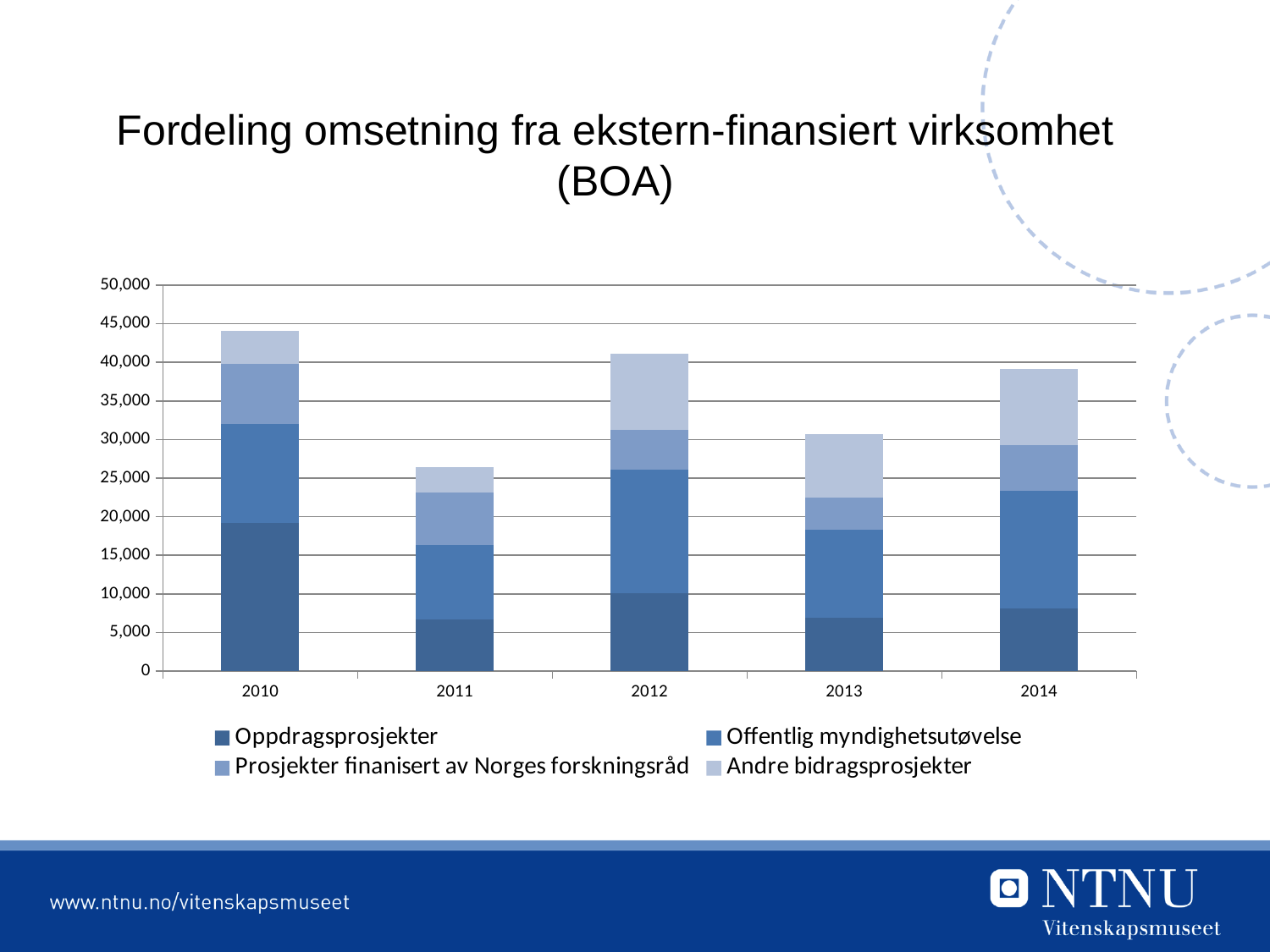
Is the total for 2010 greater or less than 40,000? greater How many years are shown on the x axis of the chart? 5 Is the total for 2011 greater or less than 30,000? less How many series does the chart's legend list? 4 What is the title of the chart on the slide? Fordeling omsetning fra ekstern-finansiert virksomhet (BOA) Which year has the larger Oppdragsprosjekter segment, 2010 or 2012? 2010 Is the Oppdragsprosjekter value for 2010 greater or less than 15,000? greater Which year has the highest total bar? 2010 What kind of chart is shown on the slide? Stacked bar chart Does the total bar rise or fall from 2010 to 2011? fall Which year has the lowest total bar? 2011